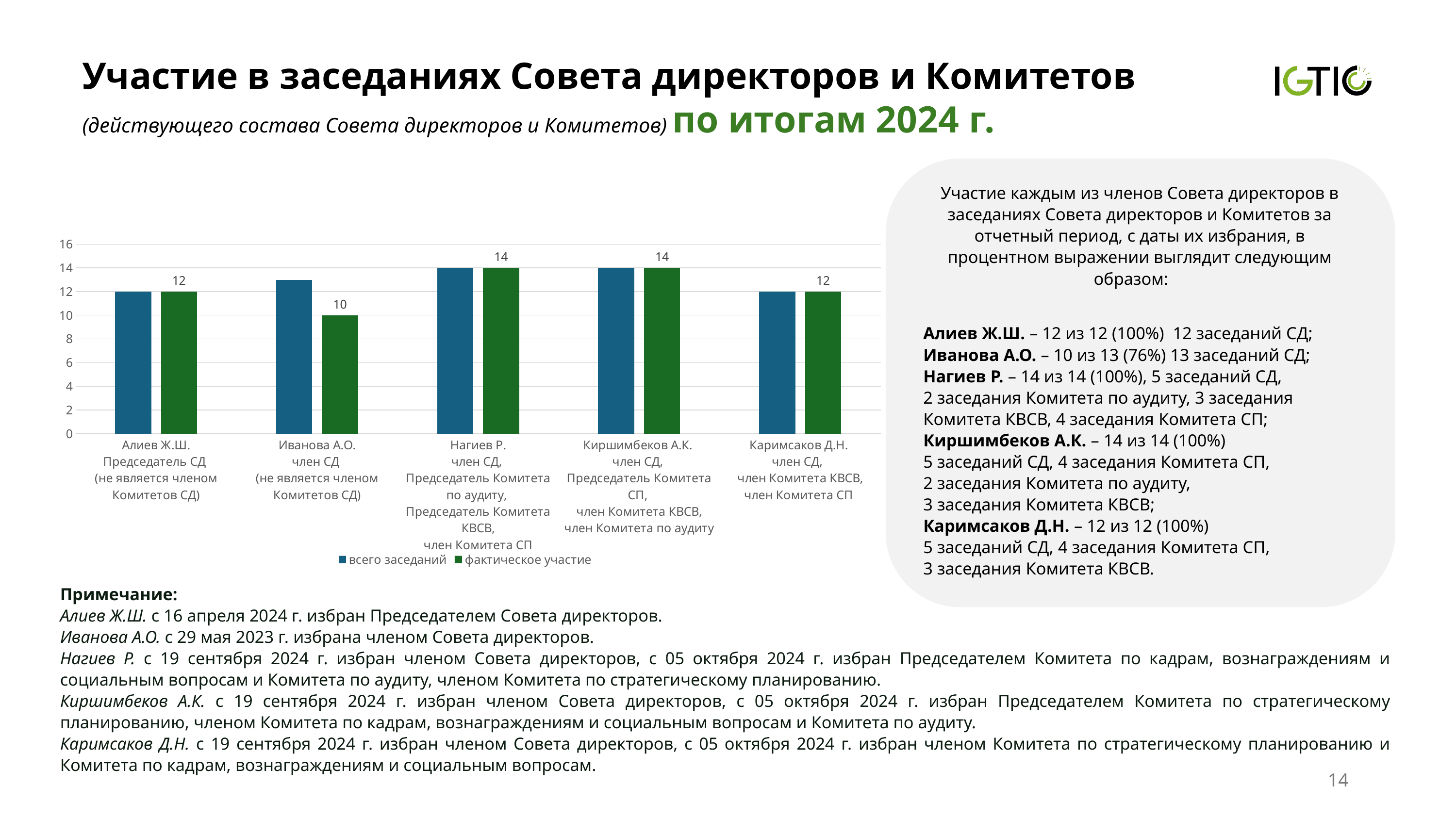
What are the two series named in the chart legend? всего заседаний, фактическое участие Which board member has the lowest value for «фактическое участие»? Иванова А.О. What is the difference between the «фактическое участие» values for Нагиев Р. and Иванова А.О.? 4 How many series does the chart legend list? 2 What kind of chart is shown on the slide? bar chart What is the value of «фактическое участие» for Каримсаков Д.Н.? 12 Is the value of «всего заседаний» for Иванова А.О. greater or less than 12? greater How many board members are shown on the x axis of the chart? 5 What is the value of «фактическое участие» for Иванова А.О.? 10 Whose «фактическое участие» value is larger, Алиев Ж.Ш. or Иванова А.О.? Алиев Ж.Ш. What colour are the bars for the series «фактическое участие»? green What is the value of «фактическое участие» for Нагиев Р.? 14